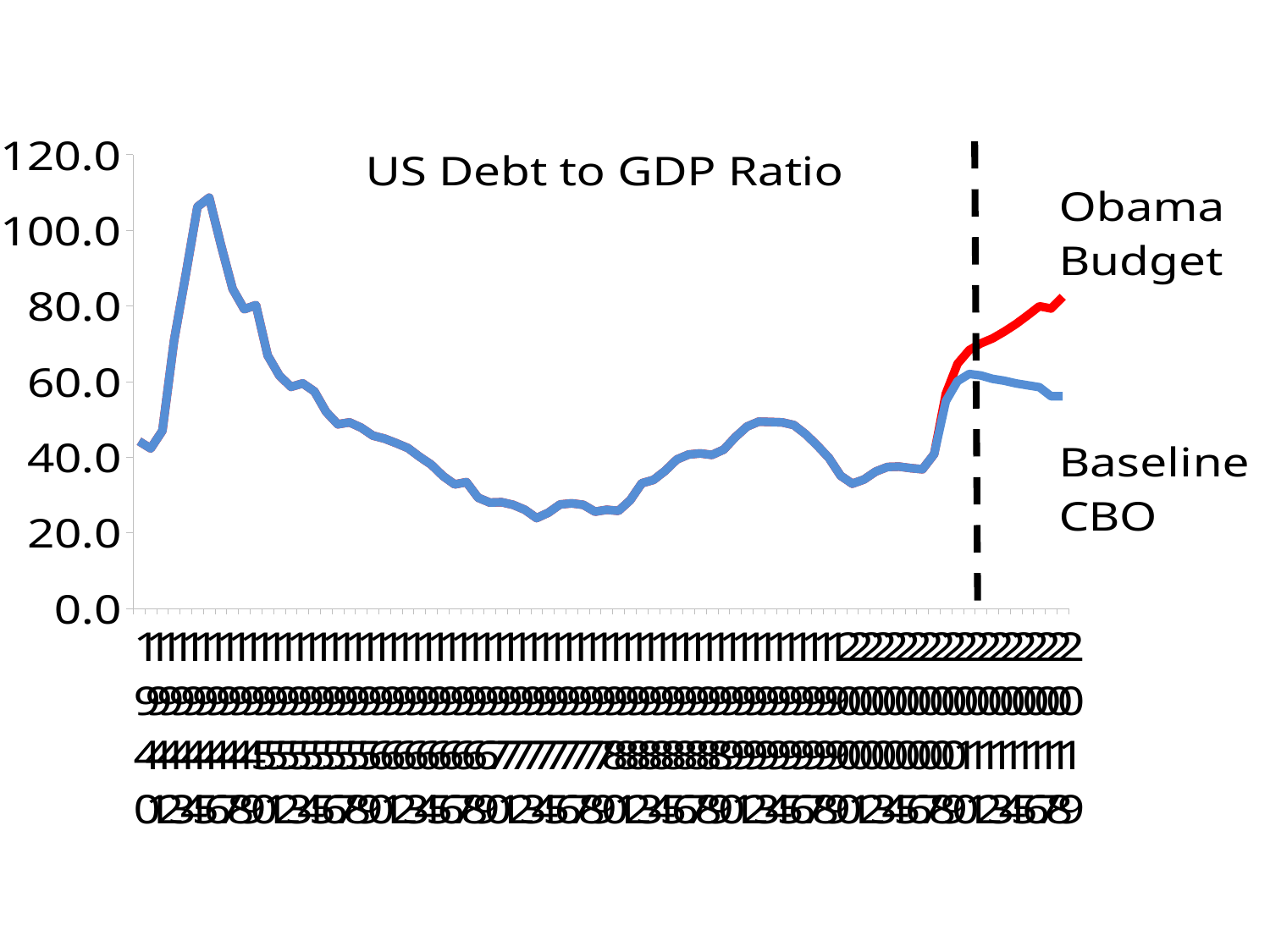
Is the peak value of the blue line greater or less than 100.0? greater How many labelled series (lines) does the chart show? 2 At the right end of the chart, which series is higher, Obama Budget or Baseline CBO? Obama Budget To the right of the dashed vertical line, does the Baseline CBO line rise or fall? fall To the right of the dashed vertical line, does the Obama Budget line rise or fall? rise What kind of chart is shown on the slide? line chart What is the title of the chart? US Debt to GDP Ratio Is the lowest value of the blue line greater or less than 40.0? less At the right end of the chart, is the Obama Budget line greater or less than 60.0? greater Which series is drawn in red? Obama Budget